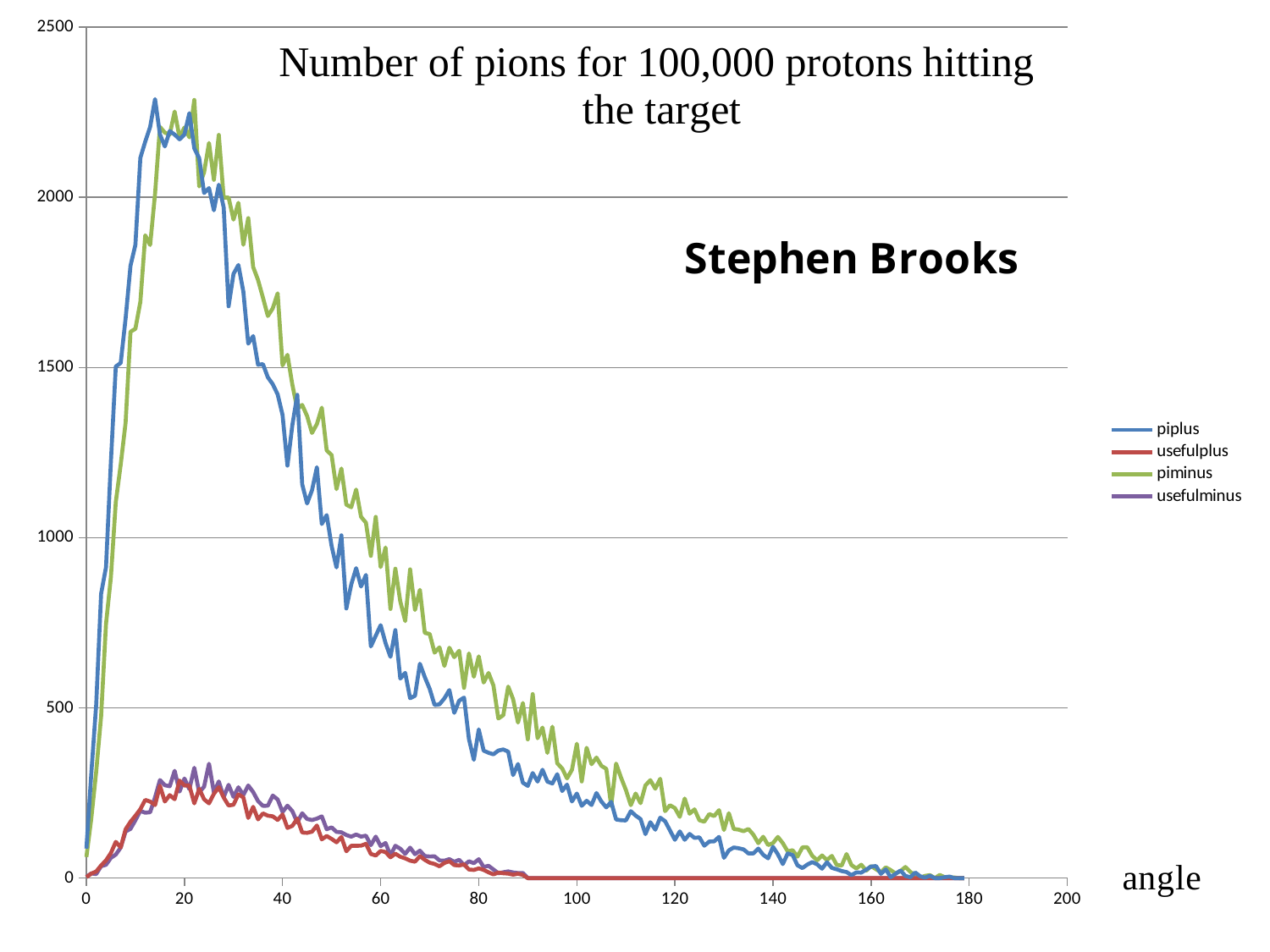
Is the value of piminus at an angle of 100 greater or less than 500? less Is the value of piplus at an angle of 60 greater or less than 500? greater What is the title of the chart? Number of pions for 100,000 protons hitting the target Which series is drawn in green? piminus Is the peak value of usefulplus greater or less than 500? less What kind of chart is shown on the slide? line chart Does the piplus series rise or fall as the angle increases from 40 to 160? fall Does the piminus series rise or fall as the angle increases from 0 to 20? rise At an angle of 100, which series has the larger value, piplus or piminus? piminus How many series does the legend list? 4